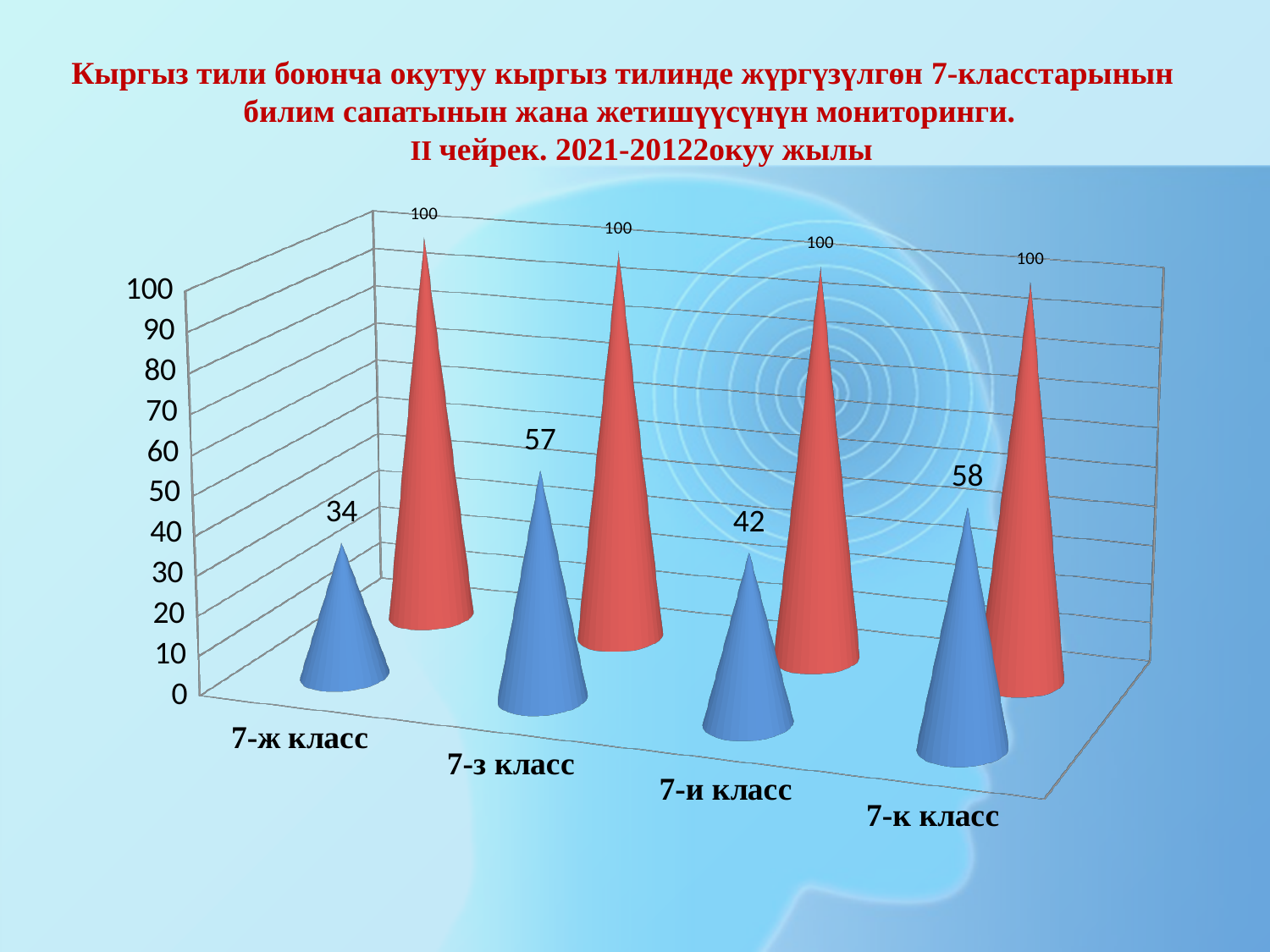
What is the value of the blue bar for 7-ж класс? 34 What is the value of the red bar for 7-и класс? 100 What type of chart is shown on the slide? bar chart What is the difference between the blue bar values for 7-з класс and 7-ж класс? 23 How many classes are shown on the x axis of the chart? 4 Which class has the lowest blue bar value? 7-ж класс What is the value of the blue bar for 7-з класс? 57 Which is larger, the blue bar for 7-з класс or the blue bar for 7-и класс? 7-з класс What is the difference between the red and blue bar values for 7-к класс? 42 What is the value of the blue bar for 7-и класс? 42 What is the value of the blue bar for 7-к класс? 58 What value do all the red bars share? 100